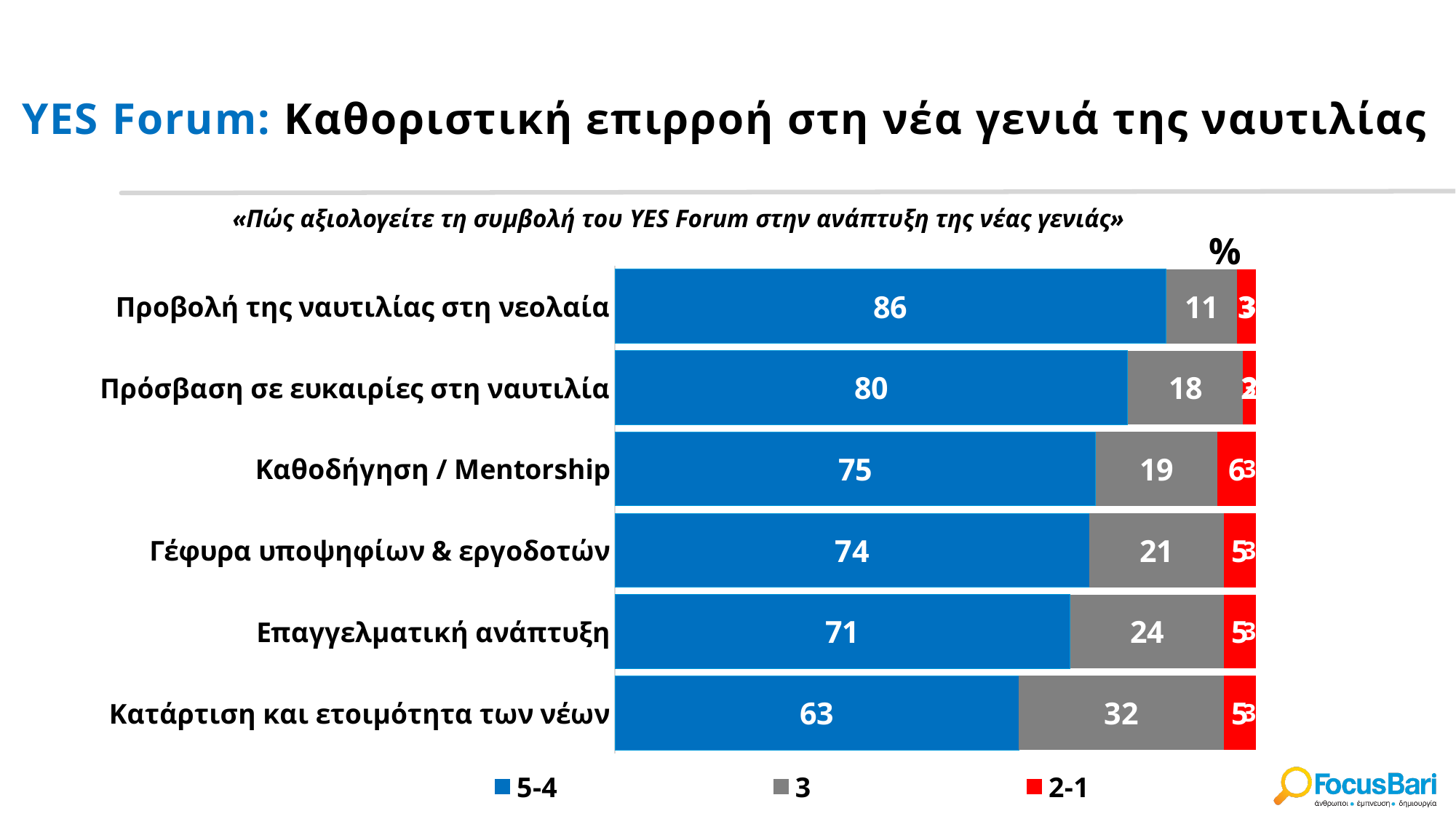
Which category has the highest value for the 5-4 series? Προβολή της ναυτιλίας στη νεολαία What is the value of the 5-4 series for Καθοδήγηση / Mentorship? 75 What kind of chart is shown on the slide? stacked bar chart Which is larger: the 3 series value for Επαγγελματική ανάπτυξη or for Γέφυρα υποψηφίων & εργοδοτών? Επαγγελματική ανάπτυξη How many series does the legend list? 3 Which category has the lowest value for the 5-4 series? Κατάρτιση και ετοιμότητα των νέων What is the value of the 3 series for Κατάρτιση και ετοιμότητα των νέων? 32 What is the value of the 5-4 series for Προβολή της ναυτιλίας στη νεολαία? 86 Which colour represents the 2-1 series in the legend? red What is the difference between the 5-4 values for Προβολή της ναυτιλίας στη νεολαία and Κατάρτιση και ετοιμότητα των νέων? 23 What is the value of the 3 series for Πρόσβαση σε ευκαιρίες στη ναυτιλία? 18 How many categories are shown in the chart? 6